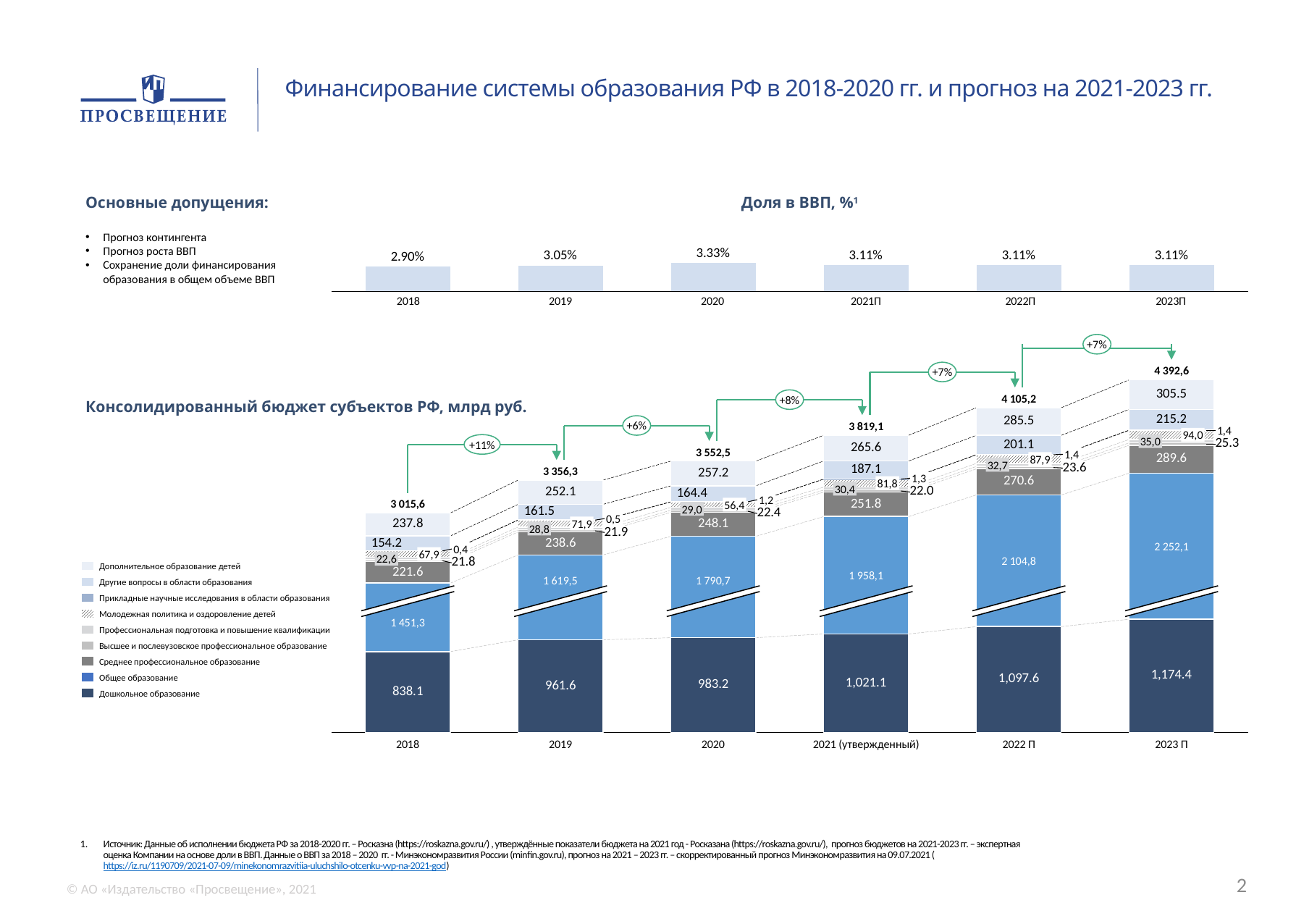
In the 'Доля в ВВП, %' chart, which year has the lowest share? 2018 In the 'Консолидированный бюджет субъектов РФ, млрд руб.' chart, what is the value of Среднее профессиональное образование in 2022 П? 270.6 In the 'Консолидированный бюджет субъектов РФ, млрд руб.' chart, how many series does the legend list? 9 In the 'Доля в ВВП, %' chart, which year has the highest share? 2020 In the 'Консолидированный бюджет субъектов РФ, млрд руб.' chart, which is larger in 2021: Дополнительное образование детей or Другие вопросы в области образования? Дополнительное образование детей In the 'Консолидированный бюджет субъектов РФ, млрд руб.' chart, what is the total for 2023 П? 4 392,6 In the 'Консолидированный бюджет субъектов РФ, млрд руб.' chart, what is the difference between Дошкольное образование in 2019 and in 2018? 123.5 In the 'Доля в ВВП, %' chart, what is the value for 2020? 3.33% In the 'Консолидированный бюджет субъектов РФ, млрд руб.' chart, do the bar totals rise or fall from 2018 to 2023 П? rise In the 'Консолидированный бюджет субъектов РФ, млрд руб.' chart, what is the value of Дошкольное образование in 2018? 838.1 In the 'Доля в ВВП, %' chart, how many years are shown on the x axis? 6 In the 'Консолидированный бюджет субъектов РФ, млрд руб.' chart, what is the value of Общее образование in 2020? 1 790,7